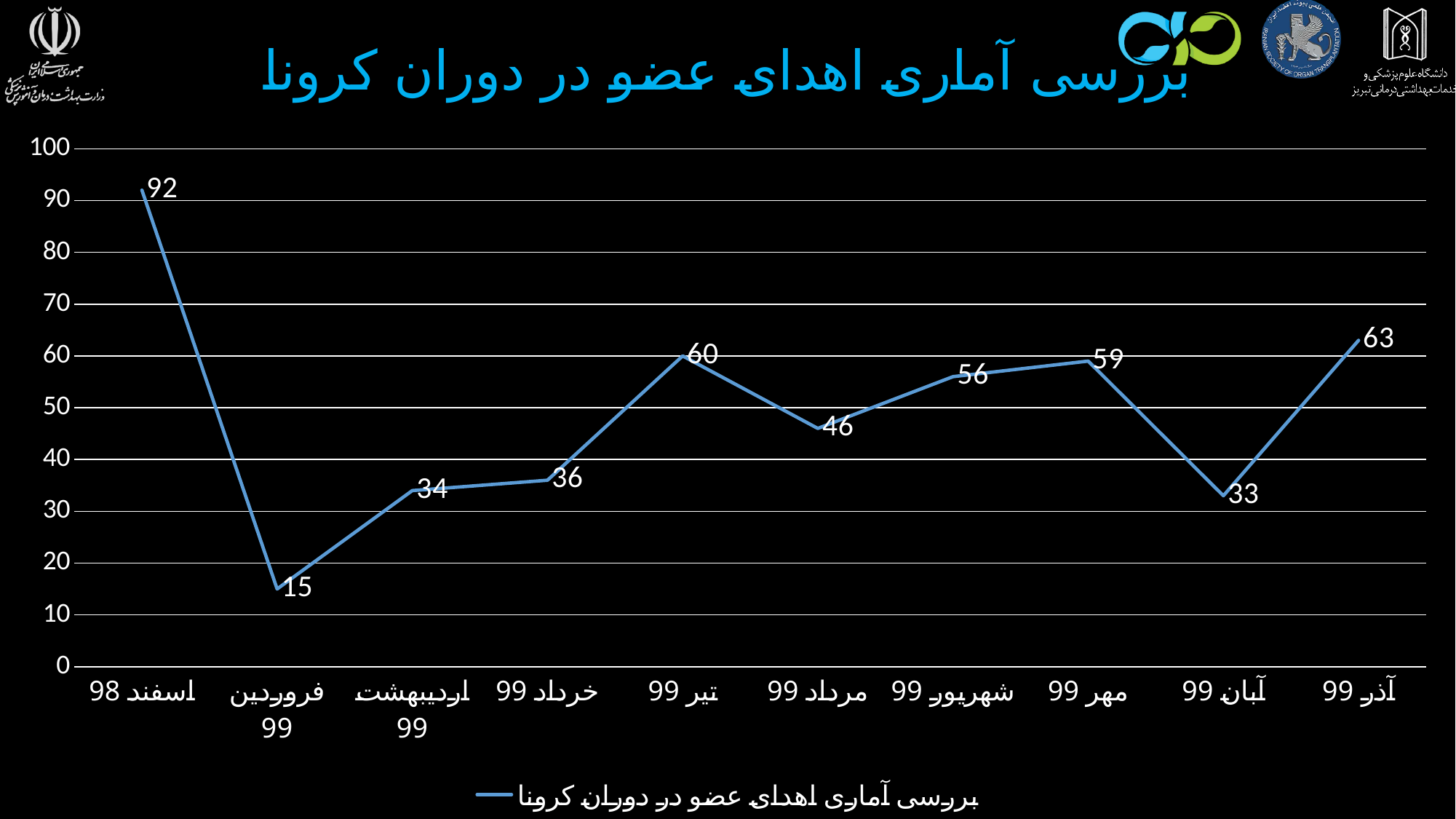
What kind of chart is shown on the slide? Line chart How many months are plotted on the x axis? 10 What is the value for مرداد 99? 46 How many series does the legend list? 1 What is the value for آذر 99? 63 What is the value for اسفند 98? 92 Which month has the highest value? اسفند 98 Does the value rise or fall from اسفند 98 to فروردین 99? Fall Which is larger, the value for شهریور 99 or the value for مهر 99? مهر 99 What is the difference between the values for تیر 99 and آبان 99? 27 What is the value for فروردین 99? 15 Which month has the lowest value? فروردین 99